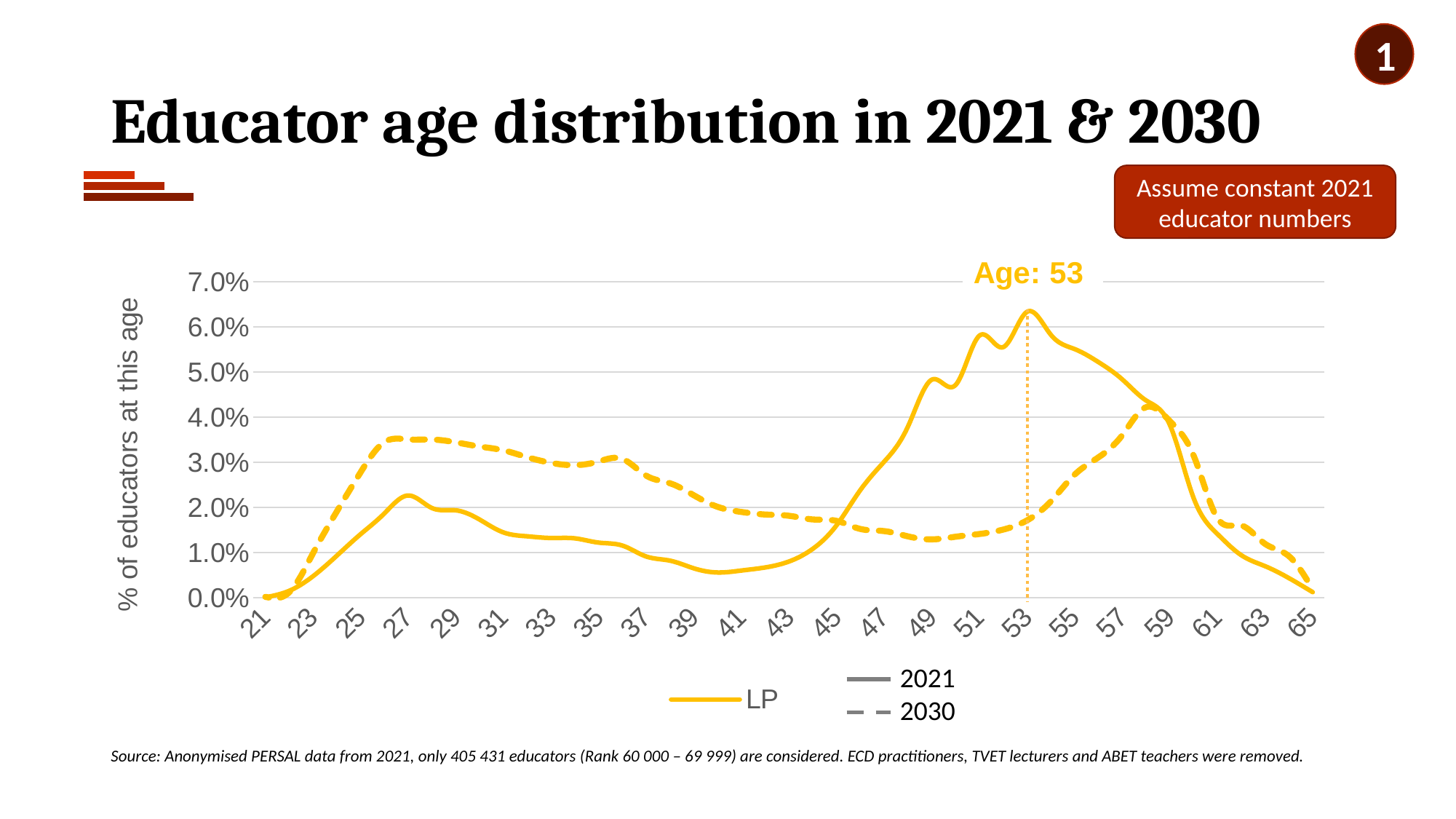
At age 53, which line is higher, 2021 or 2030? 2021 At age 27, which line is higher, 2021 or 2030? 2030 Is the 2021 value at age 41 greater or less than 1.0%? less Is the 2030 value at age 27 greater or less than 3.0%? greater Is the 2021 value at age 53 greater or less than 6.0%? greater Which line style represents 2030 in the legend? dashed At which age does the 2021 line reach its highest value? 53 Does the 2021 line rise or fall between age 53 and age 65? fall What is the title of the chart on the slide? Educator age distribution in 2021 & 2030 What kind of chart is shown on the slide? line chart